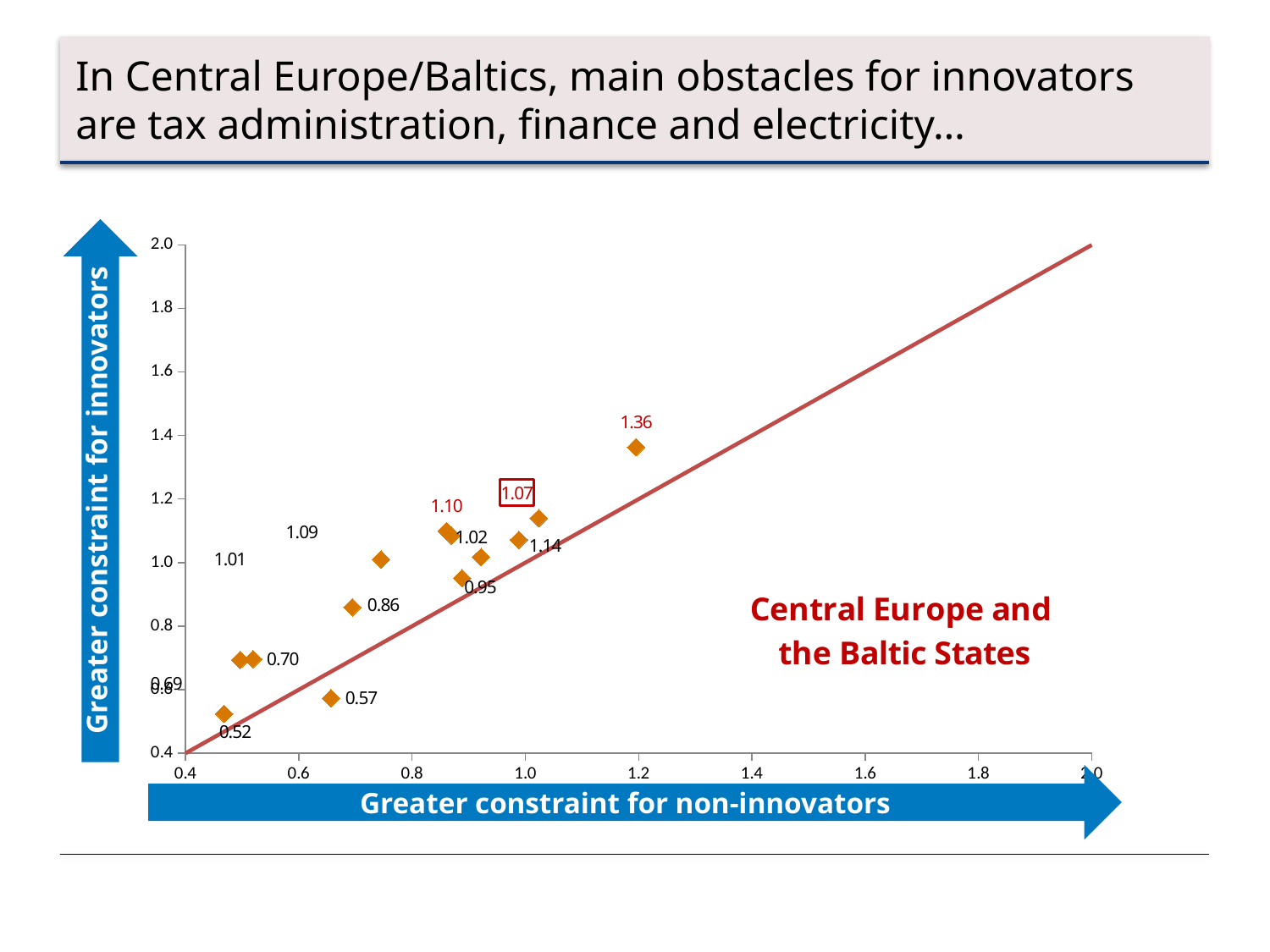
What is the lowest data label shown on the chart? 0.52 What is the maximum value shown on the horizontal axis? 2.0 Is the vertical-axis value of the point labeled 1.36 greater or less than 1.2? greater Is the vertical-axis value of the point labeled 0.57 greater or less than 0.8? less What is the difference between the highest labeled value (1.36) and the lowest labeled value (0.52)? 0.84 What is the highest data label shown on the chart? 1.36 What is the minimum value shown on the vertical axis? 0.4 What is the label of the horizontal axis? Greater constraint for non-innovators Which region is named in red text on the chart? Central Europe and the Baltic States Which is larger, the point labeled 1.36 or the point labeled 1.10? 1.36 What kind of chart is shown on the slide? scatter chart